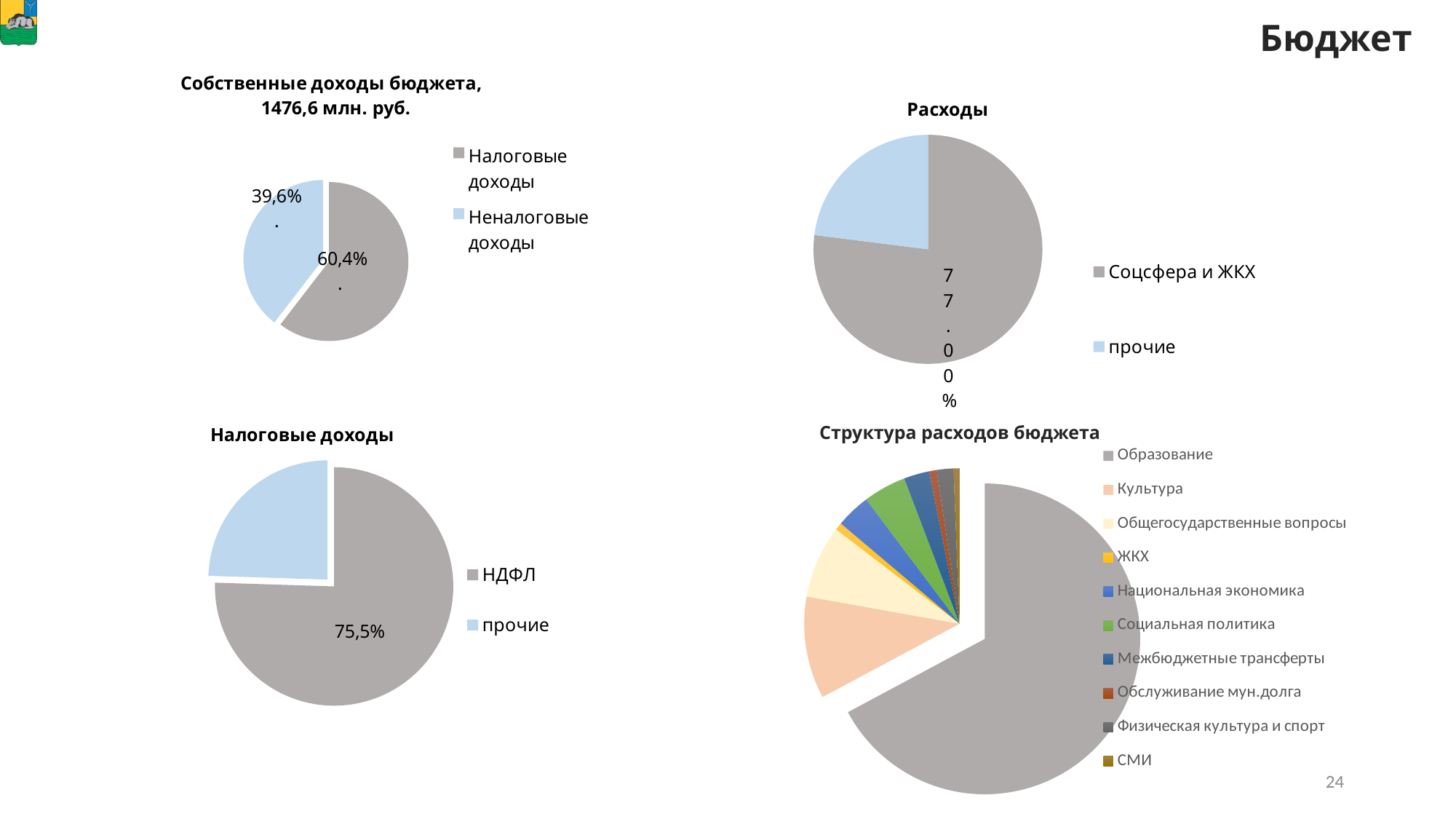
In the chart 'Расходы', what share is Соцсфера и ЖКХ? 77.00% How many slices does the chart 'Расходы' have? 2 How many categories does the legend of the chart 'Структура расходов бюджета' list? 10 What type of chart is 'Налоговые доходы'? Pie chart In the chart 'Структура расходов бюджета', which category has the largest slice? Образование In the chart 'Собственные доходы бюджета, 1476,6 млн. руб.', which slice is the largest? Налоговые доходы In the chart 'Структура расходов бюджета', which slice is larger: Культура or Общегосударственные вопросы? Культура In the chart 'Налоговые доходы', what share is НДФЛ? 75,5% In the chart 'Собственные доходы бюджета, 1476,6 млн. руб.', by how many percentage points does Налоговые доходы exceed Неналоговые доходы? 20,8 In the chart 'Собственные доходы бюджета, 1476,6 млн. руб.', what share is Неналоговые доходы? 39,6% In the chart 'Собственные доходы бюджета, 1476,6 млн. руб.', what share is Налоговые доходы? 60,4% In the chart 'Налоговые доходы', which slice is larger: НДФЛ or прочие? НДФЛ